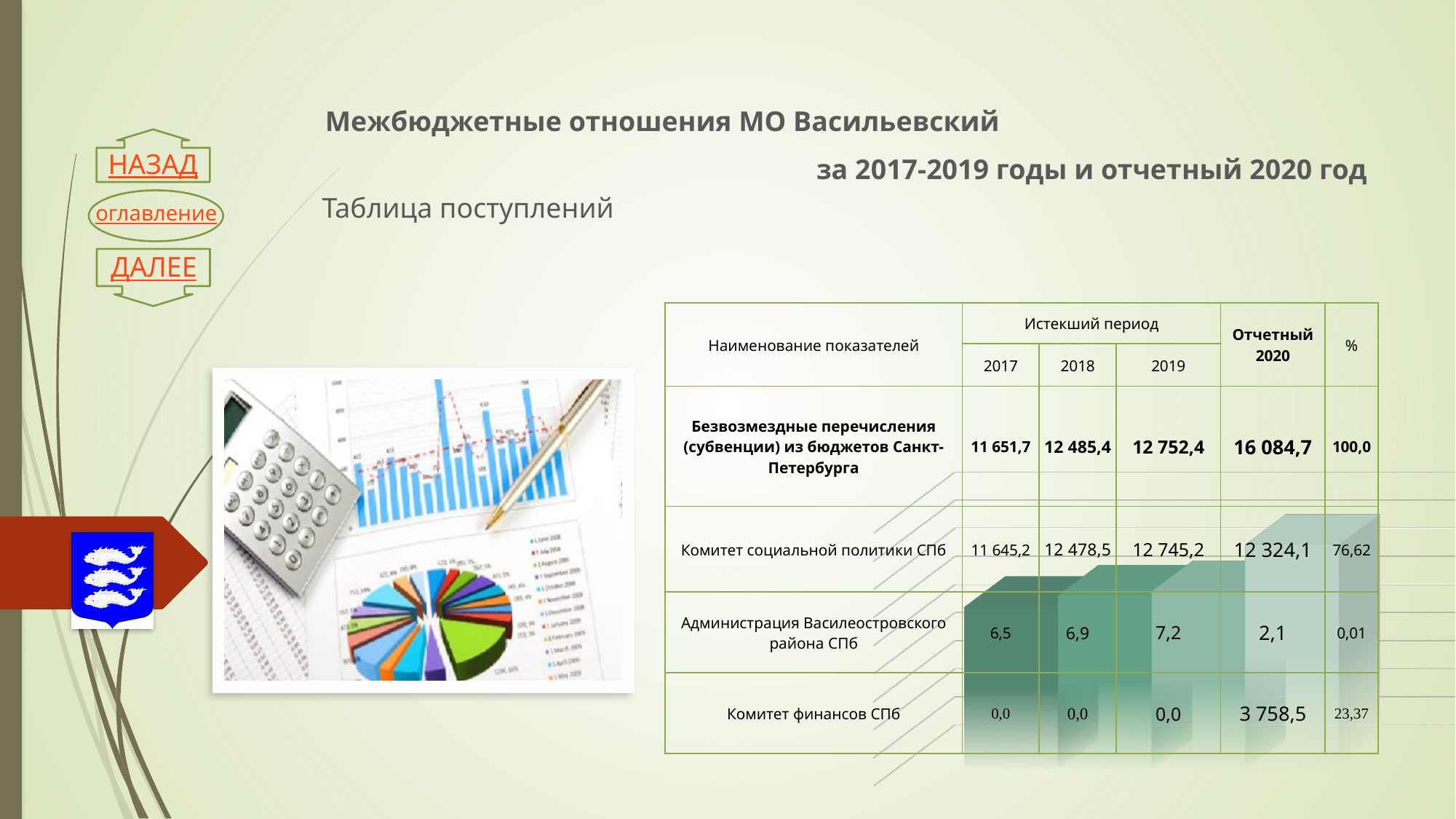
In the table, what is the value for Комитет финансов СПб in Отчетный 2020? 3 758,5 In the table, what is the value of Безвозмездные перечисления (субвенции) из бюджетов Санкт-Петербурга for Отчетный 2020? 16 084,7 In the table, what is the value for Администрация Василеостровского района СПб in 2017? 6,5 In the table, which is larger for Комитет социальной политики СПб: the 2019 value or the Отчетный 2020 value? 2019 Do the bars in the 3D bar chart behind the table rise or fall from left to right? rise In the table, which row has the lowest value in the % column? Администрация Василеостровского района СПб What kind of chart is drawn behind the table on the right of the slide? bar chart In the table, what is the difference between the 2018 and 2017 values for Безвозмездные перечисления (субвенции) из бюджетов Санкт-Петербурга? 833,7 How many bars does the 3D bar chart behind the table show? 4 In the table, which year has the highest value for Безвозмездные перечисления (субвенции) из бюджетов Санкт-Петербурга? 2020 In the table, what is the value for Комитет социальной политики СПб in 2019? 12 745,2 In the table, what percentage share does Комитет социальной политики СПб have in the % column? 76,62